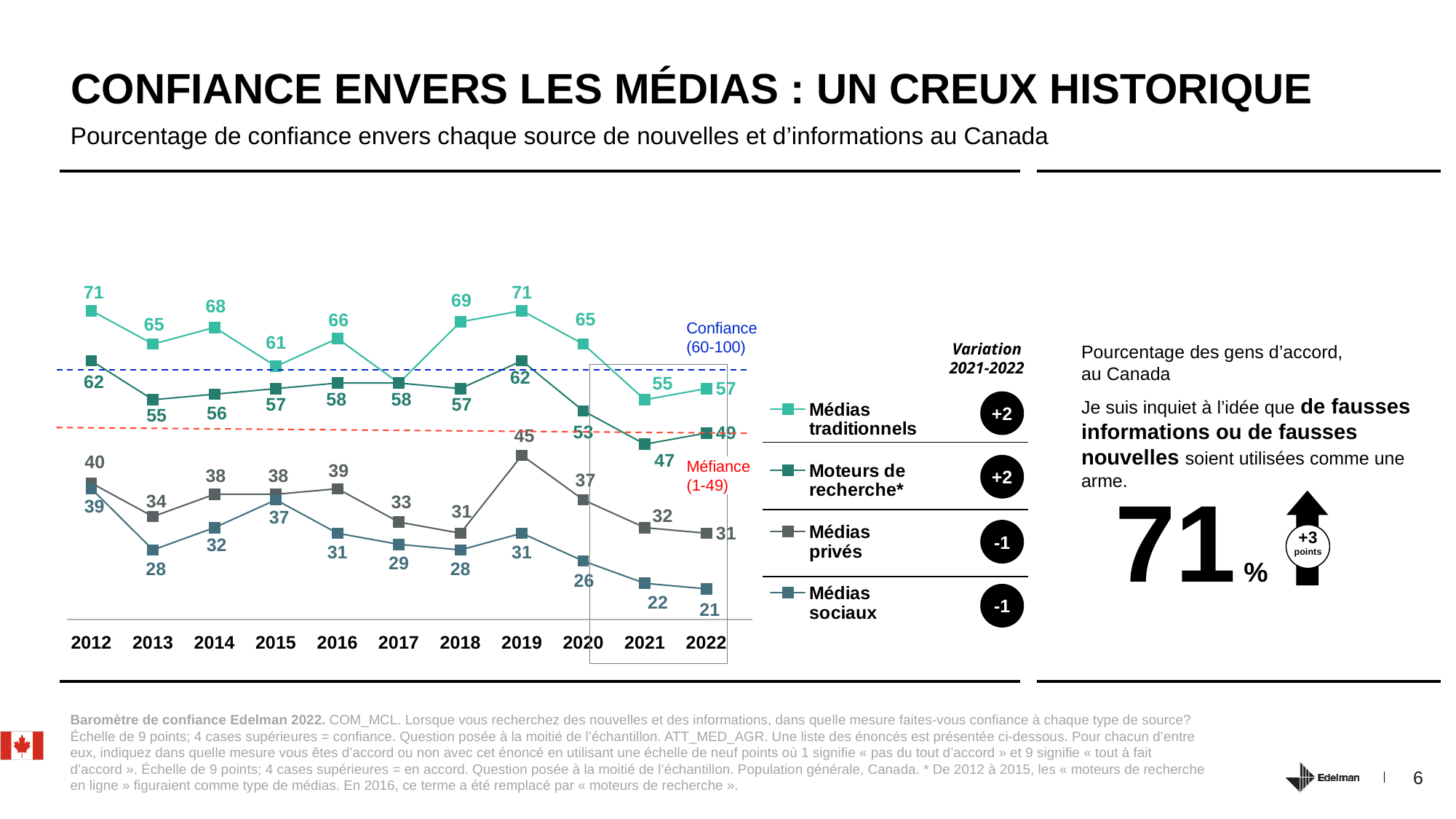
What is the Variation 2021-2022 shown for Médias traditionnels? +2 Does the value for Médias sociaux rise or fall from 2019 to 2022? fall What type of chart is shown on the slide? line chart What is the value for Moteurs de recherche* in 2020? 53 What is the value for Médias sociaux in 2021? 22 How many series does the chart legend list? 4 What is the value for Médias traditionnels in 2022? 57 Which is larger in 2021: Moteurs de recherche* or Médias privés? Moteurs de recherche* How many years are shown on the x axis of the chart? 11 In which year does Médias sociaux reach its lowest value? 2022 In which year does Médias privés reach its highest value? 2019 What is the difference between Médias traditionnels and Médias sociaux in 2022? 36